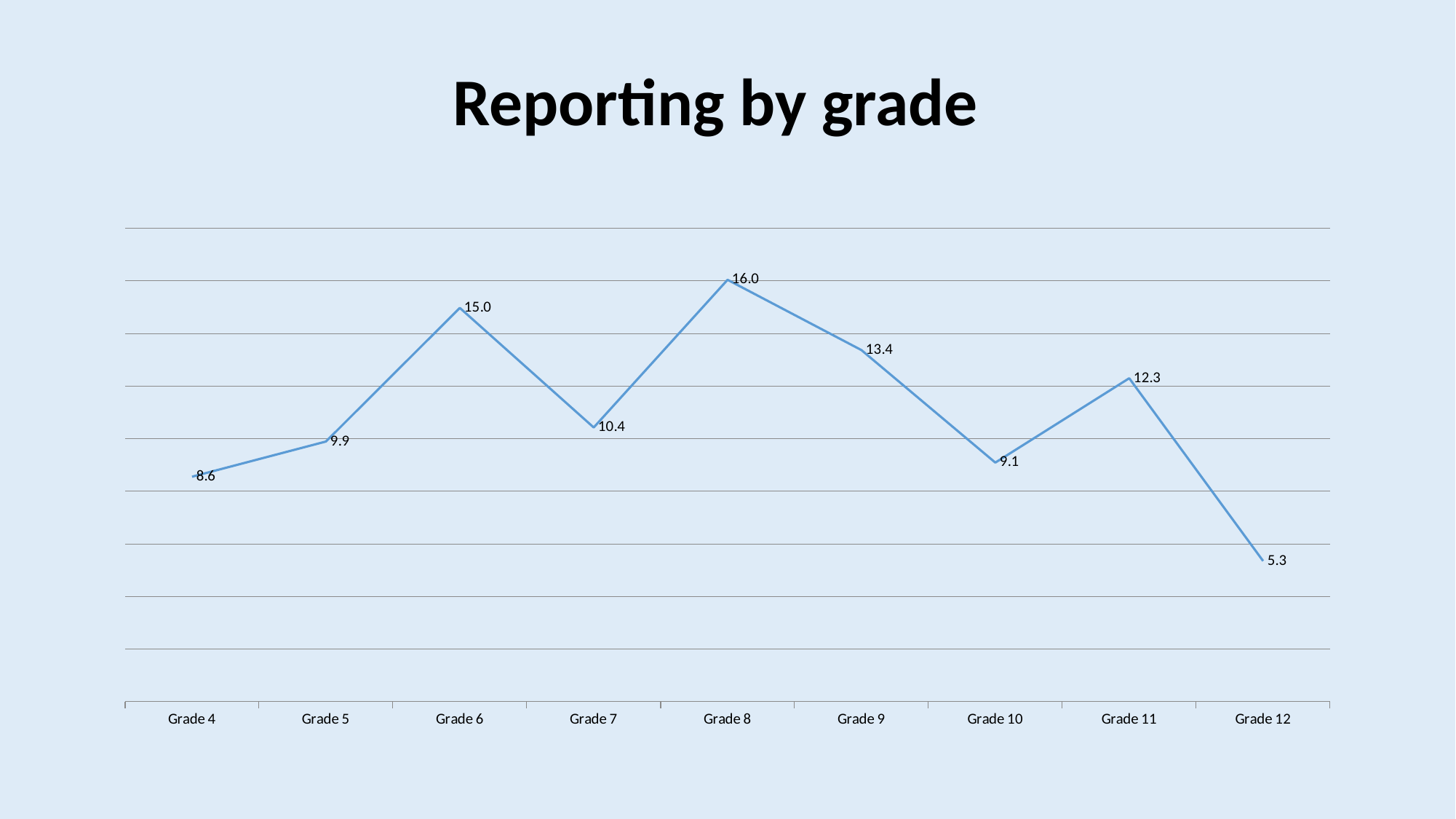
Which grade has the highest value? Grade 8 How many grades are plotted on the chart? 9 What is the value for Grade 12? 5.3 What is the difference between the values for Grade 8 and Grade 7? 5.6 What is the title of the chart? Reporting by grade What is the difference between the values for Grade 6 and Grade 5? 5.1 What is the value for Grade 10? 9.1 What kind of chart is shown on the slide? Line chart Which grade has the lowest value? Grade 12 What is the value for Grade 8? 16.0 Which is larger, the value for Grade 9 or the value for Grade 11? Grade 9 What is the value for Grade 4? 8.6